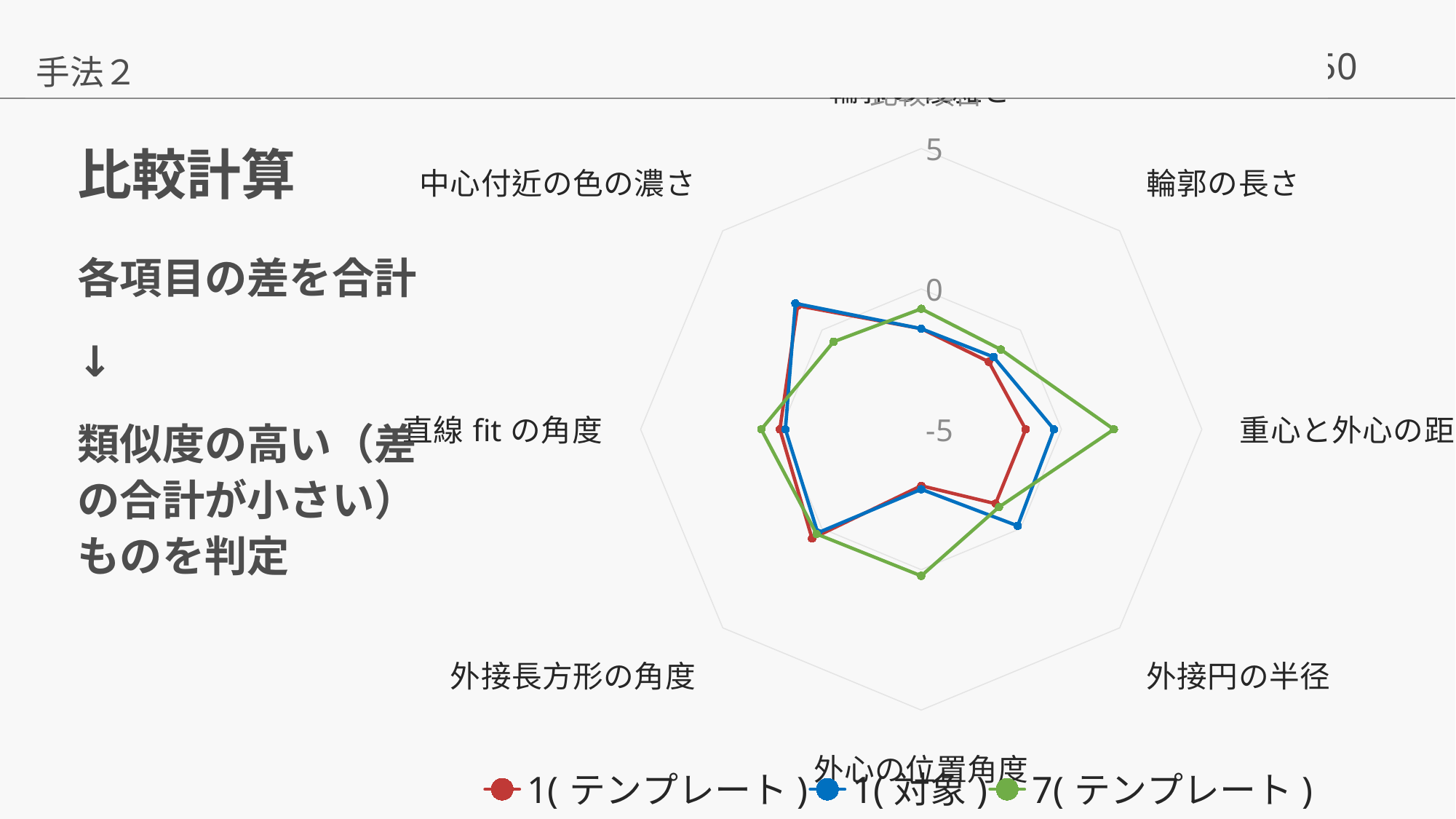
On the right-hand axis (重心と外心の距…), which series has the highest value? 7( テンプレート ) For 中心付近の色の濃さ, which is larger: the value of 1( 対象 ) or the value of 7( テンプレート )? 1( 対象 ) Which series is drawn in red in the radar chart? 1( テンプレート ) Is the value of 1( テンプレート ) for 外心の位置角度 greater or less than 0? less How many axes (categories) does the radar chart have? 8 Is the value of 7( テンプレート ) for 輪郭の長さ greater or less than 0? less Is the value of 7( テンプレート ) for 直線 fit の角度 greater or less than 0? greater How many series does the legend of the radar chart list? 3 Which series is drawn in green in the radar chart? 7( テンプレート ) What kind of chart is shown on the slide? radar chart